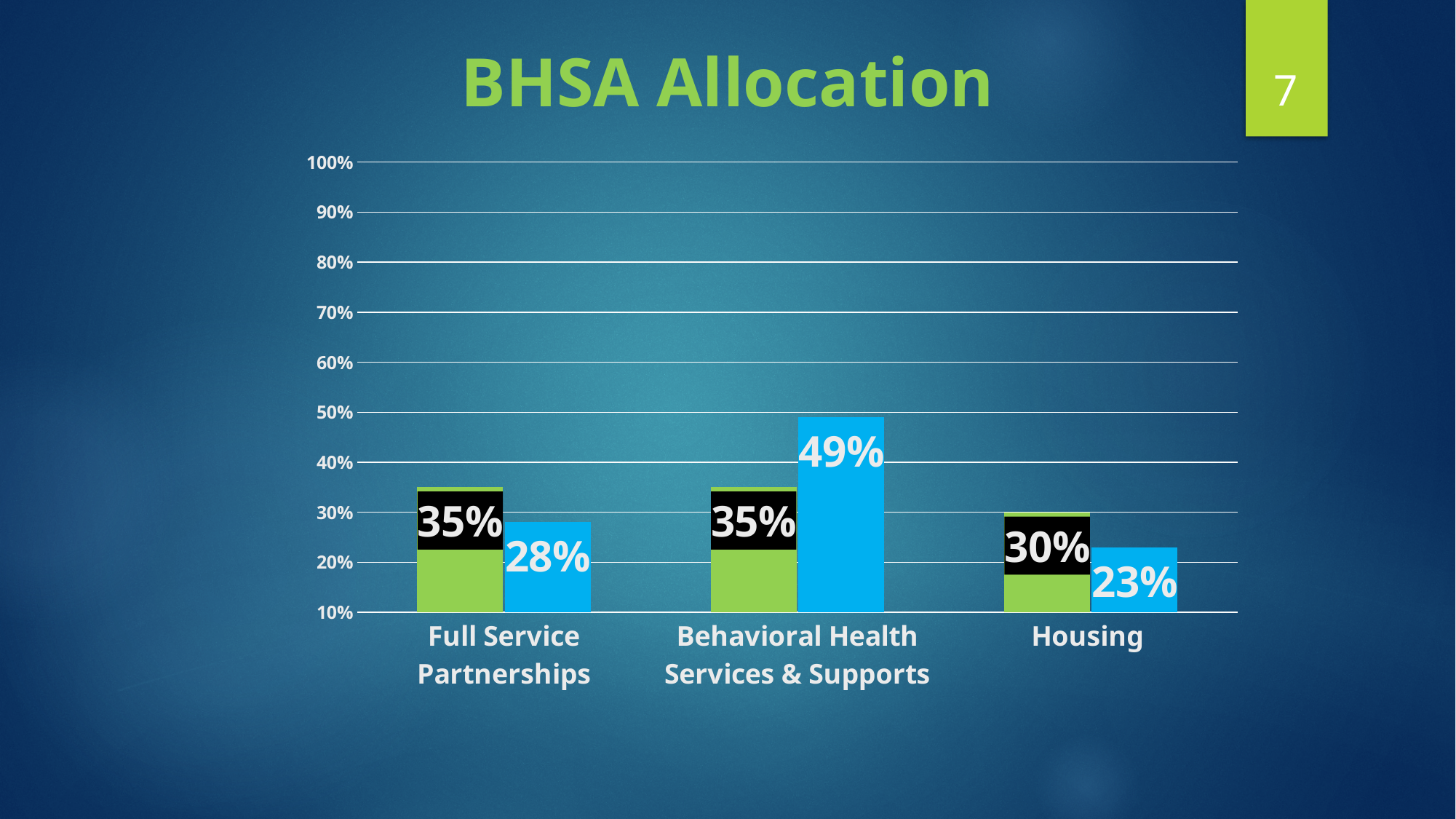
Which category has the highest blue bar? Behavioral Health Services & Supports What is the value of the blue bar for Housing? 23% What is the value of the blue bar for Behavioral Health Services & Supports? 49% What kind of chart is shown on the slide? bar chart What is the title of the chart? BHSA Allocation What is the value of the green bar for Housing? 30% Which category has the lowest blue bar? Housing How many categories are shown on the x axis? 3 What is the difference between the blue bar and the green bar for Behavioral Health Services & Supports? 14% For Full Service Partnerships, which is larger, the green bar or the blue bar? the green bar What is the value of the green bar for Full Service Partnerships? 35% What is the difference between the green bar and the blue bar for Housing? 7%